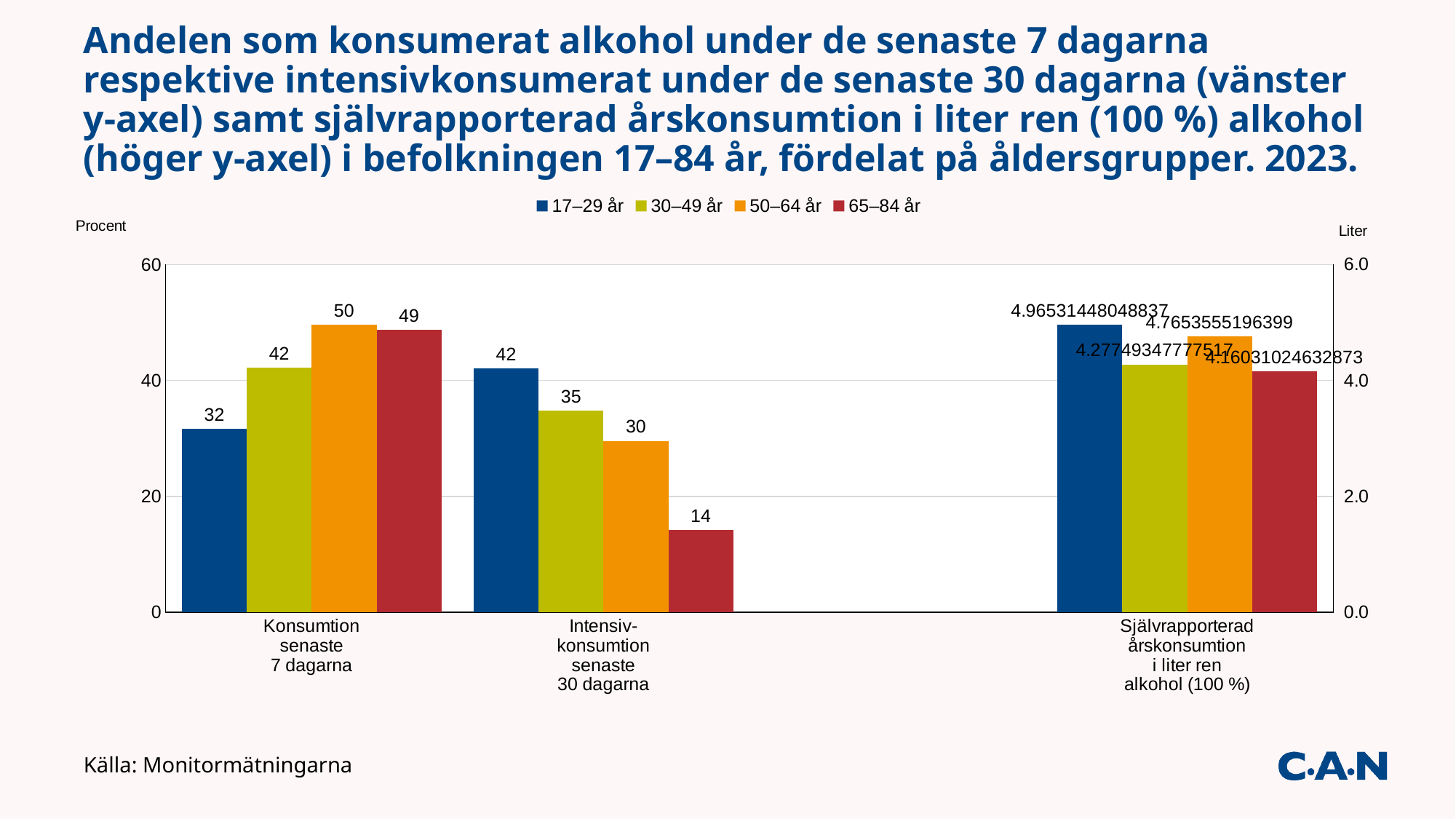
What is the difference between the 30–49 år and 65–84 år values for Intensivkonsumtion senaste 30 dagarna? 21 What kind of chart is shown on the slide? Bar chart Is the value for the 17–29 år group for Självrapporterad årskonsumtion greater or less than 4.0 liter? greater What is the value for the 50–64 år group for Konsumtion senaste 7 dagarna? 50 Which age group has the lowest value for Konsumtion senaste 7 dagarna? 17–29 år Which age group has the highest value for Intensivkonsumtion senaste 30 dagarna? 17–29 år For Konsumtion senaste 7 dagarna, which is larger: the value for 30–49 år or for 65–84 år? 65–84 år What is the unit label of the right y axis? Liter What is the value for the 65–84 år group for Intensivkonsumtion senaste 30 dagarna? 14 What is the value for the 17–29 år group for Konsumtion senaste 7 dagarna? 32 How many series does the legend list? 4 How many category groups are shown on the x axis? 3